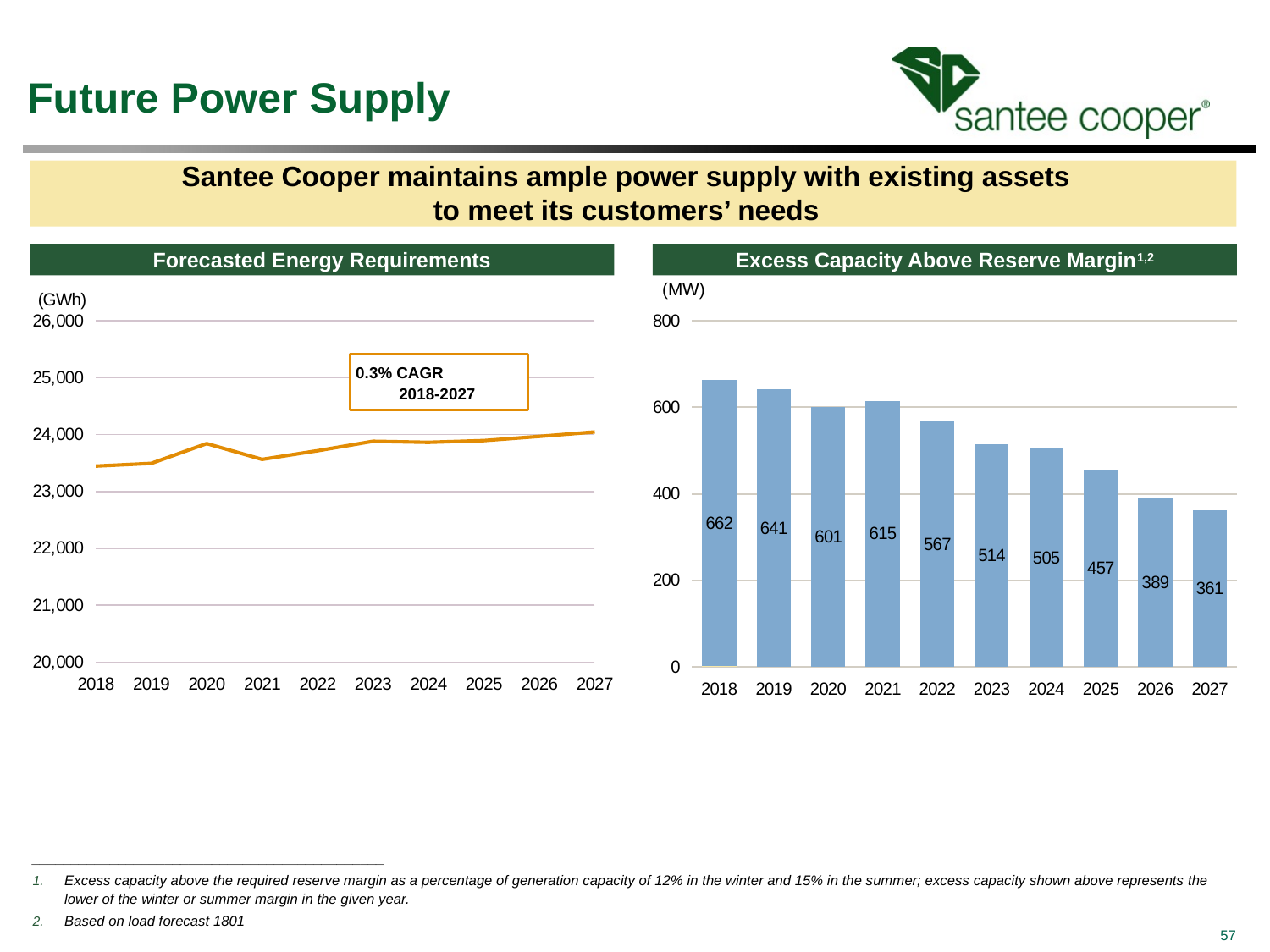
What kind of chart is the Excess Capacity Above Reserve Margin chart? Bar chart In the Excess Capacity Above Reserve Margin chart, which year has the highest value? 2018 In the Excess Capacity Above Reserve Margin chart, which year has the lowest value? 2027 How many years are shown in the Excess Capacity Above Reserve Margin chart? 10 What CAGR for 2018-2027 is shown on the Forecasted Energy Requirements chart? 0.3% CAGR In the Excess Capacity Above Reserve Margin chart, which is larger, the value for 2020 or the value for 2021? 2021 In the Excess Capacity Above Reserve Margin chart, what is the difference between the 2018 and 2027 values? 301 In the Excess Capacity Above Reserve Margin chart, what is the value for 2018? 662 In the Excess Capacity Above Reserve Margin chart, what is the value for 2023? 514 In the Forecasted Energy Requirements chart, is the value for 2027 greater or less than 24,000? greater What kind of chart is the Forecasted Energy Requirements chart? Line chart In the Excess Capacity Above Reserve Margin chart, what is the value for 2027? 361